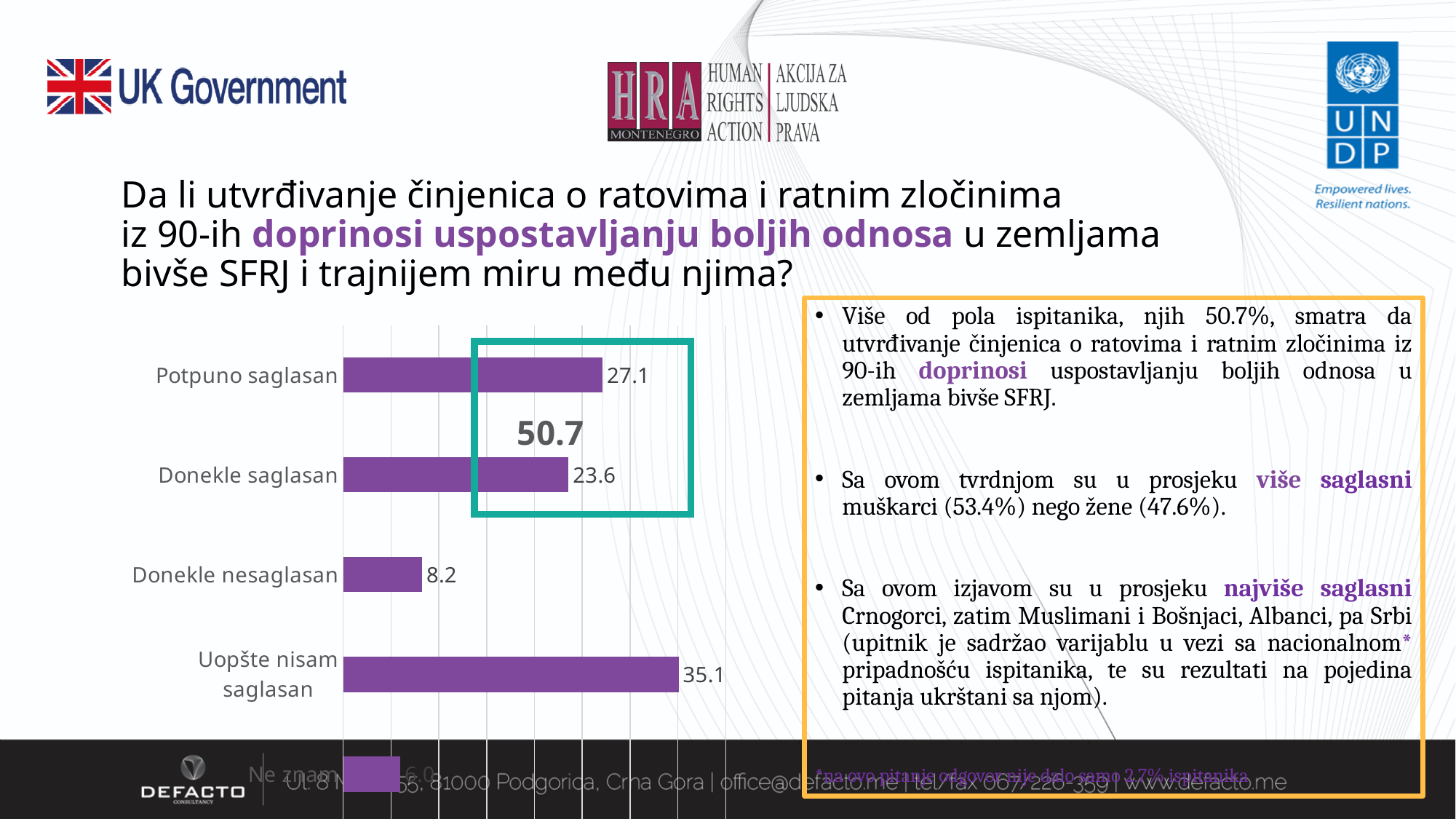
What is the difference between the values for Uopšte nisam saglasan and Potpuno saglasan? 8.0 What colour are the bars in the chart? purple What is the value for Donekle saglasan? 23.6 Which is larger, the value for Donekle nesaglasan or Uopšte nisam saglasan? Uopšte nisam saglasan What is the value for Potpuno saglasan? 27.1 What is the value for Donekle nesaglasan? 8.2 What is the difference between the values for Donekle saglasan and Donekle nesaglasan? 15.4 Which category has the highest value? Uopšte nisam saglasan Which is larger, the value for Potpuno saglasan or Donekle saglasan? Potpuno saglasan What combined value is printed inside the highlighted box around Potpuno saglasan and Donekle saglasan? 50.7 What is the value for Uopšte nisam saglasan? 35.1 What kind of chart is shown on the slide? bar chart